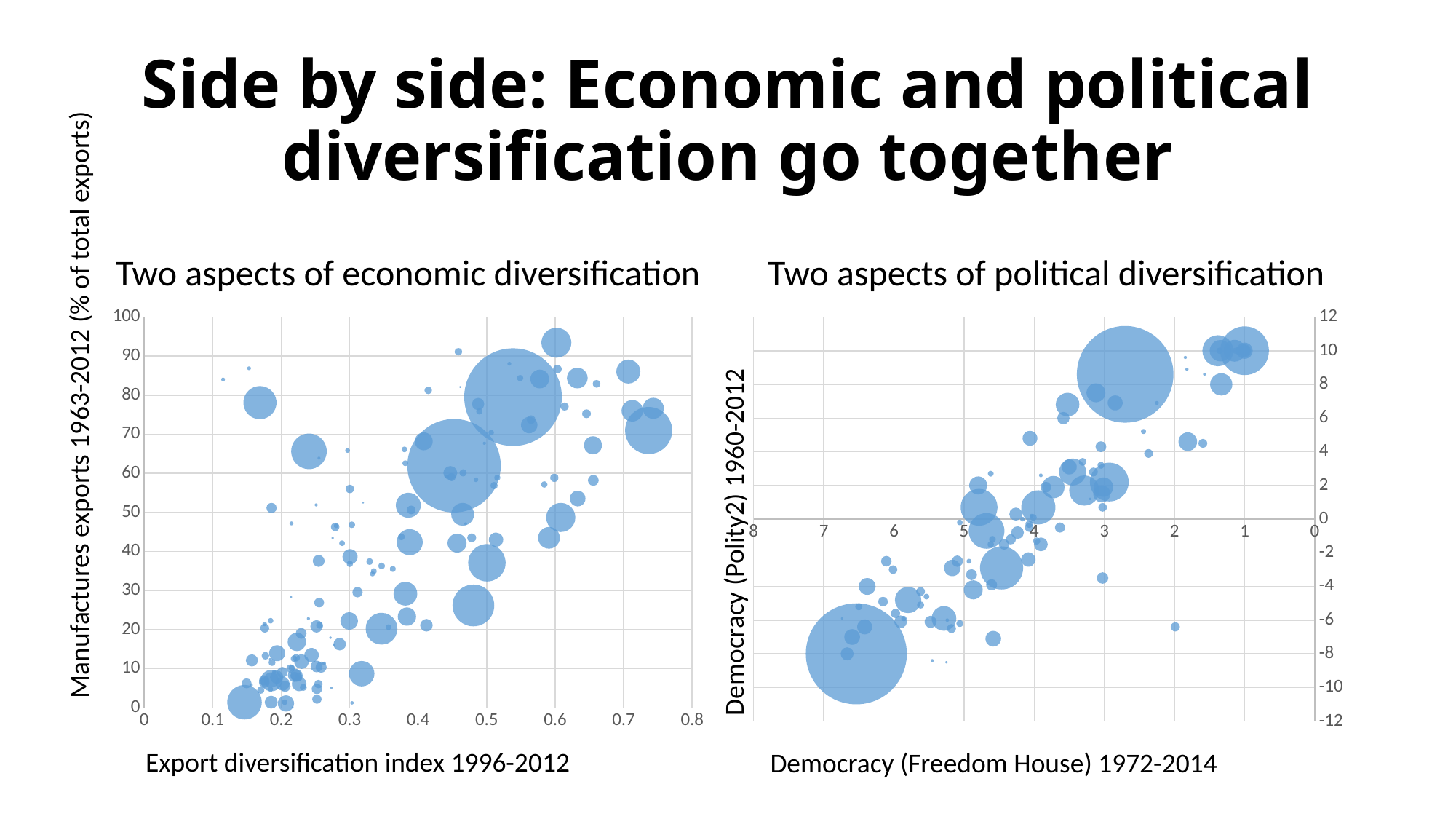
In the right chart 'Two aspects of political diversification', do the Polity2 values generally rise or fall moving from left to right along the x axis? Rise In the left chart 'Two aspects of economic diversification', do the plotted values generally rise or fall as the export diversification index increases along the x axis? Rise What kind of chart is the right chart titled 'Two aspects of political diversification'? Bubble chart What is the y-axis label of the right chart 'Two aspects of political diversification'? Democracy (Polity2) 1960-2012 What kind of chart is the left chart titled 'Two aspects of economic diversification'? Bubble chart What is the x-axis label of the left chart 'Two aspects of economic diversification'? Export diversification index 1996-2012